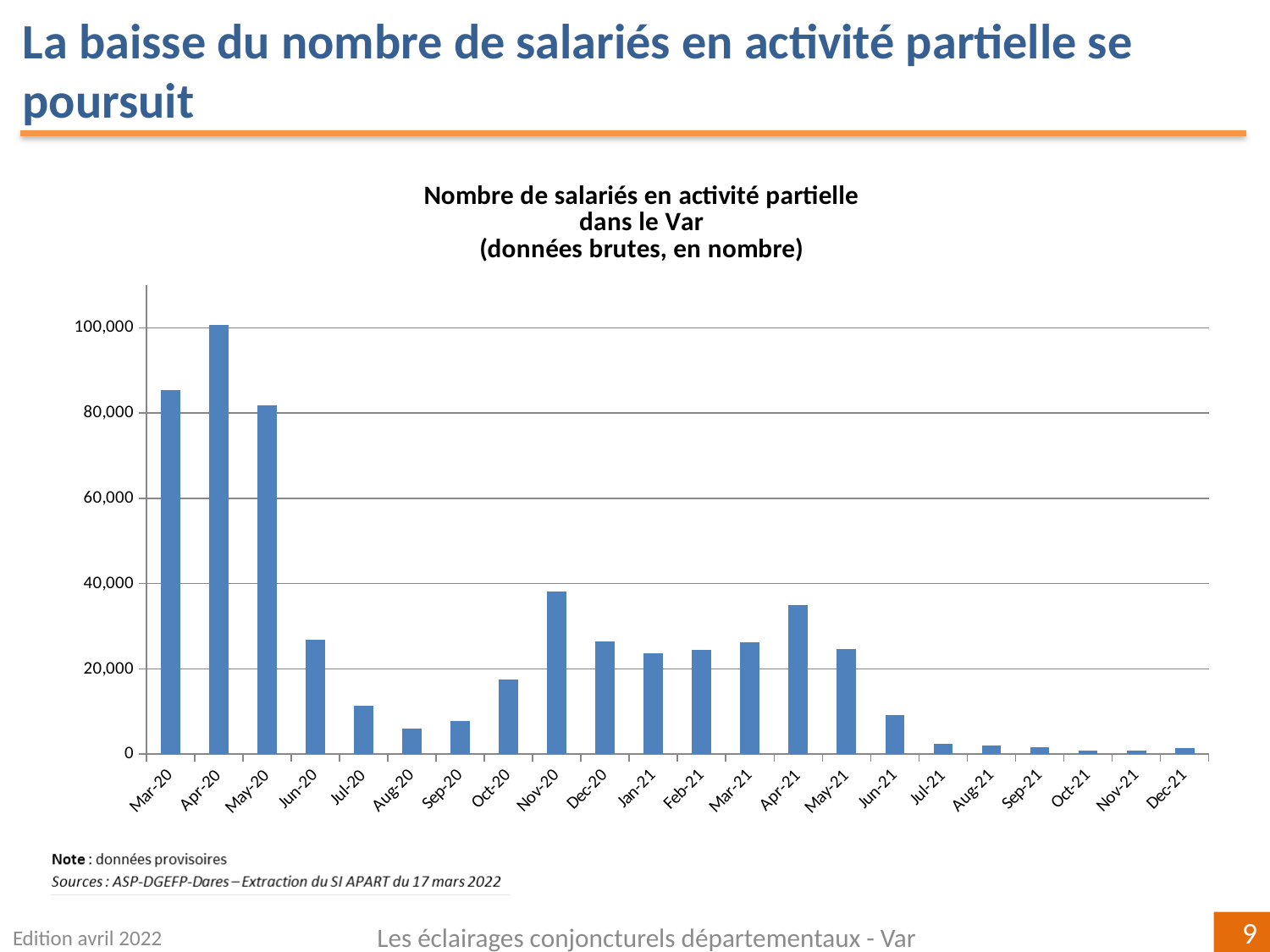
Which is larger, the value for Apr-20 or the value for Mar-20? Apr-20 Is the value for Nov-20 greater or less than 40,000? less What kind of chart is shown on the slide? bar chart Is the value for Jun-20 greater or less than 20,000? greater How many months are plotted on the x axis? 22 Which is larger, the value for Nov-20 or the value for Dec-20? Nov-20 Is the value for Mar-20 greater or less than 80,000? greater Which month has the highest number of salariés en activité partielle? Apr-20 What is the title of the chart? Nombre de salariés en activité partielle dans le Var (données brutes, en nombre) Overall, do the values rise or fall from Mar-20 to Dec-21? fall